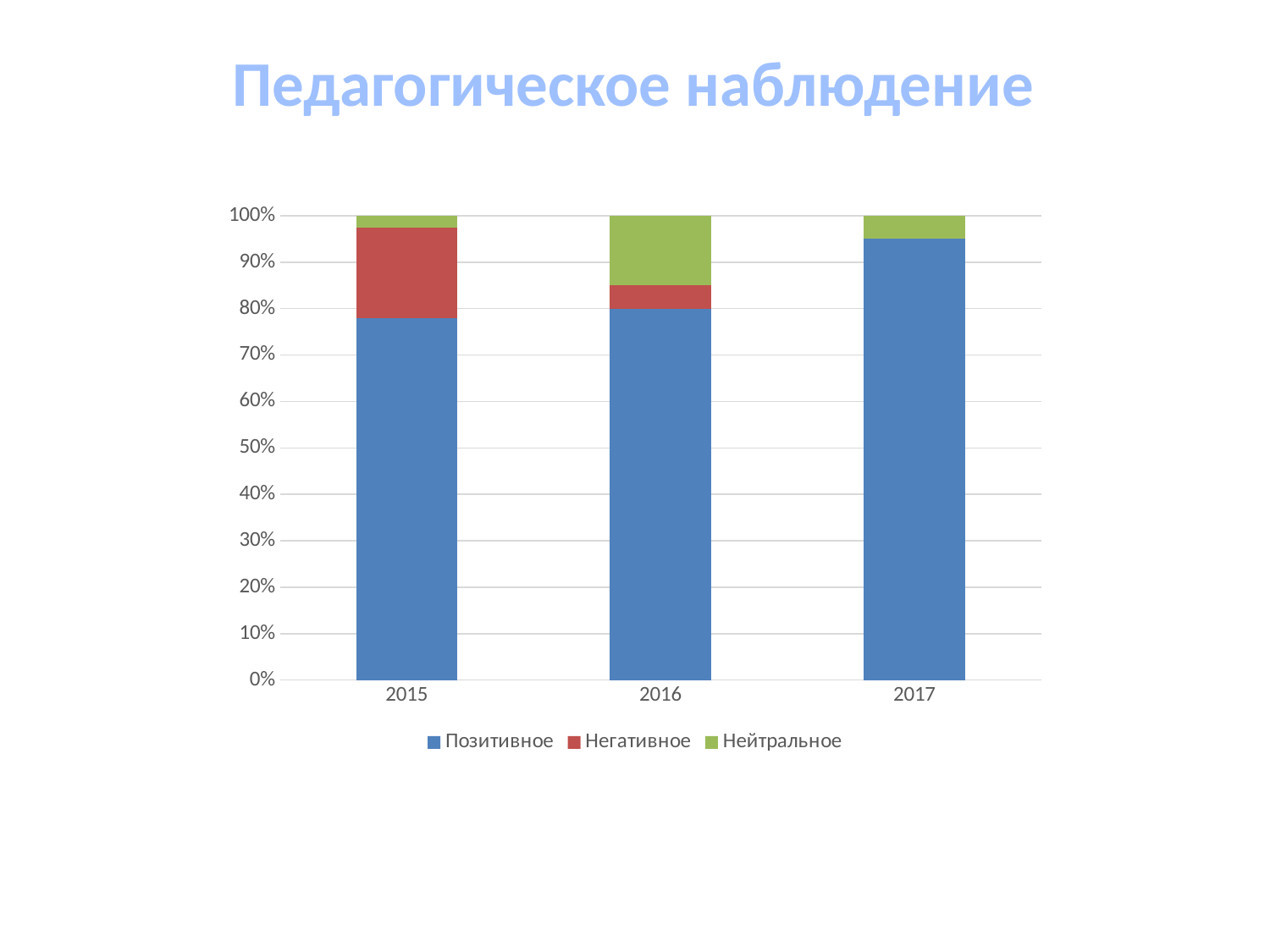
Is the value for Позитивное in 2015 greater or less than 70%? greater What is the title of the slide? Педагогическое наблюдение In which year is the Позитивное share the highest? 2017 Is the value for Позитивное in 2017 greater or less than 90%? greater Which series is shown in blue? Позитивное How many years are shown on the x axis? 3 What kind of chart is shown on the slide? stacked bar chart How many series does the legend list? 3 In which year is the Негативное share the highest? 2015 Is the value for Негативное in 2015 greater or less than 10%? greater Does the Позитивное share rise or fall from 2015 to 2017? rise